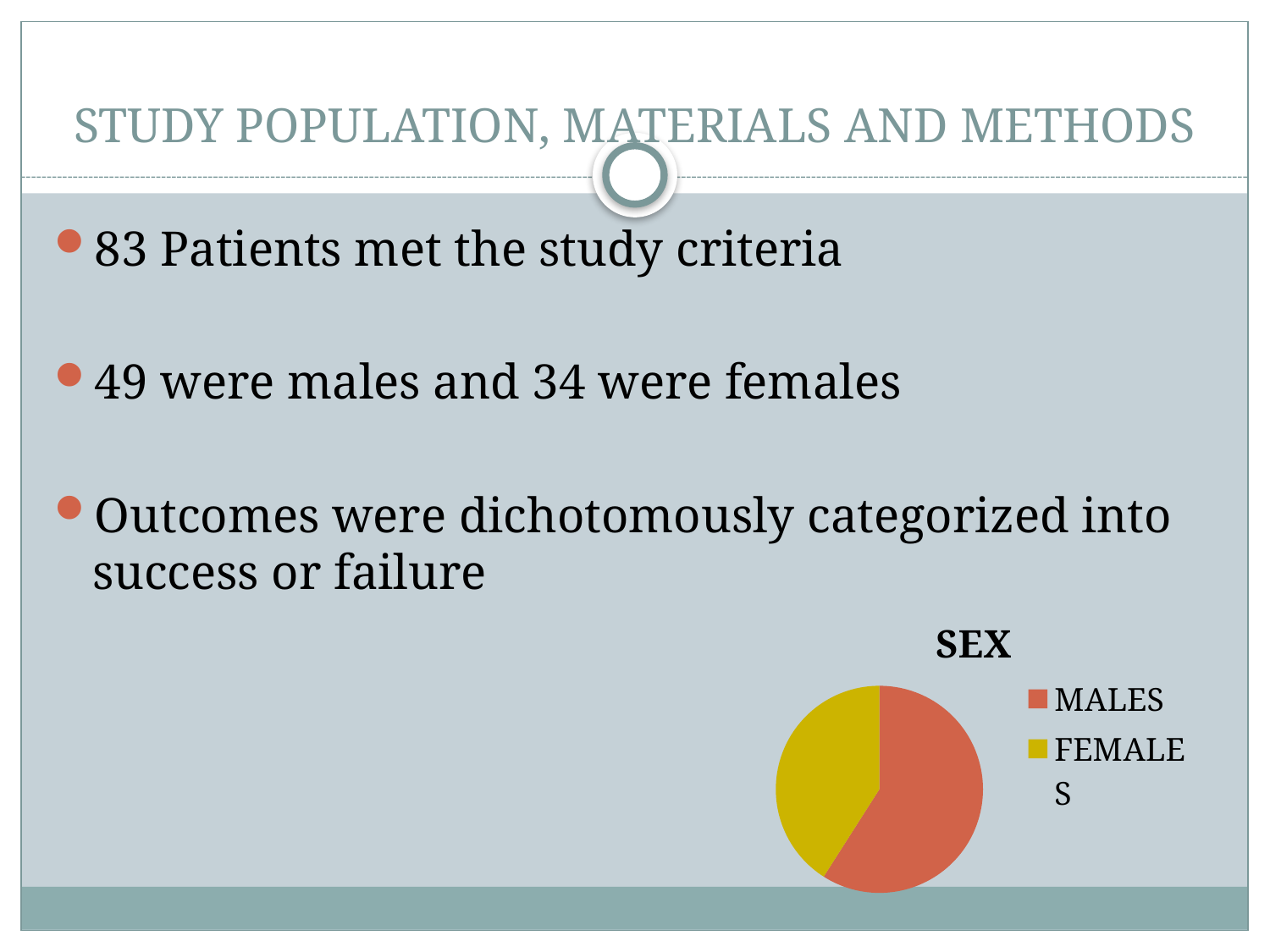
Which slice is larger in the pie chart, MALES or FEMALES? MALES According to the slide, how many patients are in the MALES slice of the pie chart? 49 Which category has the largest slice in the pie chart? MALES What is the title of the pie chart? SEX According to the slide, how many more males than females are represented in the pie chart? 15 How many slices does the pie chart have? 2 How many entries does the legend of the pie chart list? 2 What kind of chart is shown on the slide? pie chart According to the slide, how many patients are in the FEMALES slice of the pie chart? 34 Which category has the smallest slice in the pie chart? FEMALES According to the slide, what is the total number of patients represented in the pie chart? 83 What colour is the MALES slice in the pie chart? red